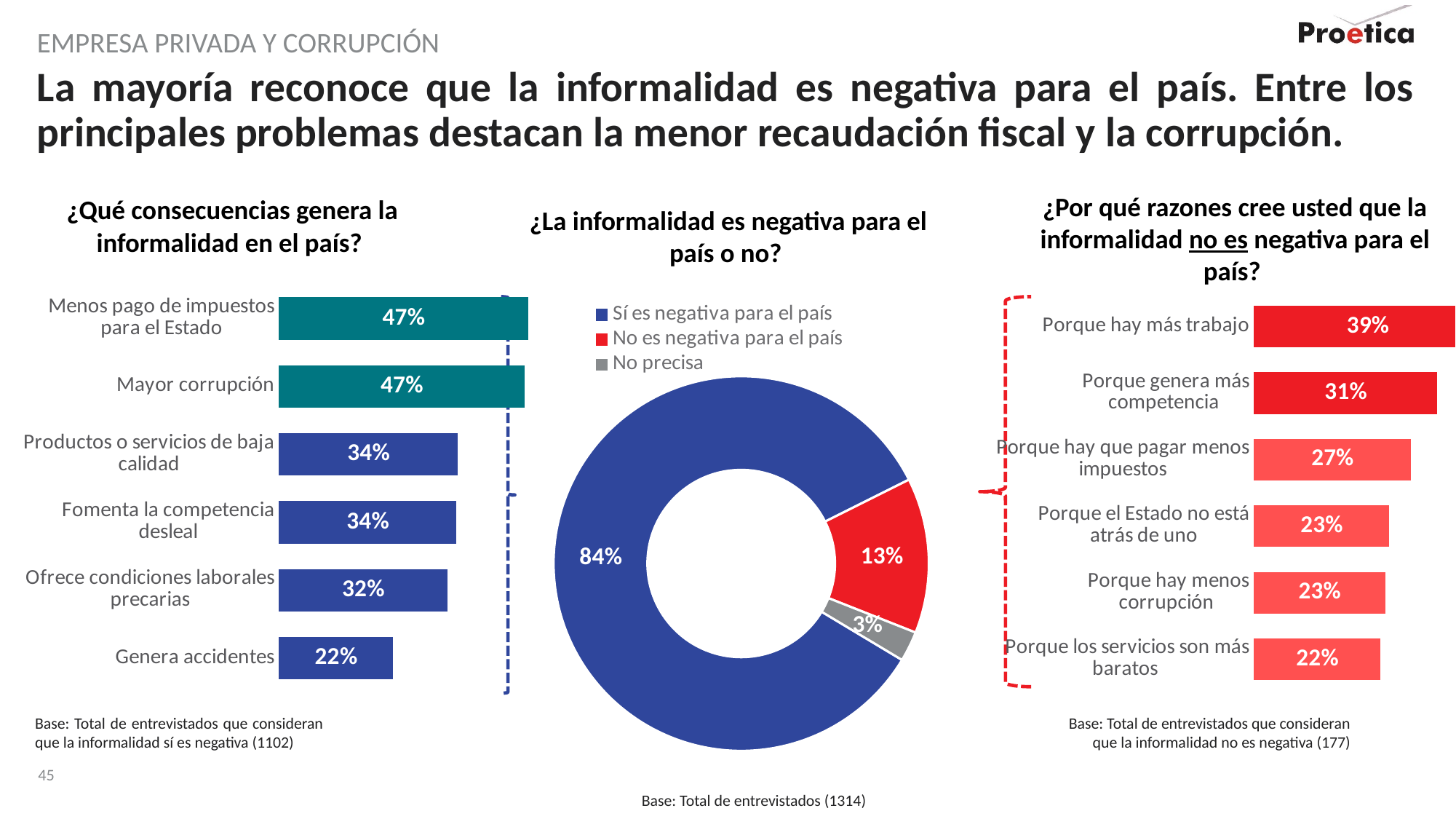
In the right chart '¿Por qué razones cree usted que la informalidad no es negativa para el país?', which is larger: 'Porque genera más competencia' or 'Porque los servicios son más baratos'? Porque genera más competencia In the middle chart '¿La informalidad es negativa para el país o no?', what share corresponds to 'No precisa'? 3% In the left chart '¿Qué consecuencias genera la informalidad en el país?', which category has the lowest value? Genera accidentes What kind of chart is the middle chart '¿La informalidad es negativa para el país o no?'? Pie (donut) chart In the right chart '¿Por qué razones cree usted que la informalidad no es negativa para el país?', what is the value for 'Porque hay que pagar menos impuestos'? 27% In the left chart '¿Qué consecuencias genera la informalidad en el país?', what is the difference between 'Mayor corrupción' and 'Genera accidentes'? 25% In the left chart '¿Qué consecuencias genera la informalidad en el país?', what is the value for 'Genera accidentes'? 22% In the left chart '¿Qué consecuencias genera la informalidad en el país?', how many categories are shown? 6 In the middle chart '¿La informalidad es negativa para el país o no?', what share corresponds to 'No es negativa para el país'? 13% In the left chart '¿Qué consecuencias genera la informalidad en el país?', what is the value for 'Ofrece condiciones laborales precarias'? 32% In the right chart '¿Por qué razones cree usted que la informalidad no es negativa para el país?', which category has the highest value? Porque hay más trabajo In the middle chart '¿La informalidad es negativa para el país o no?', how many entries does the legend list? 3